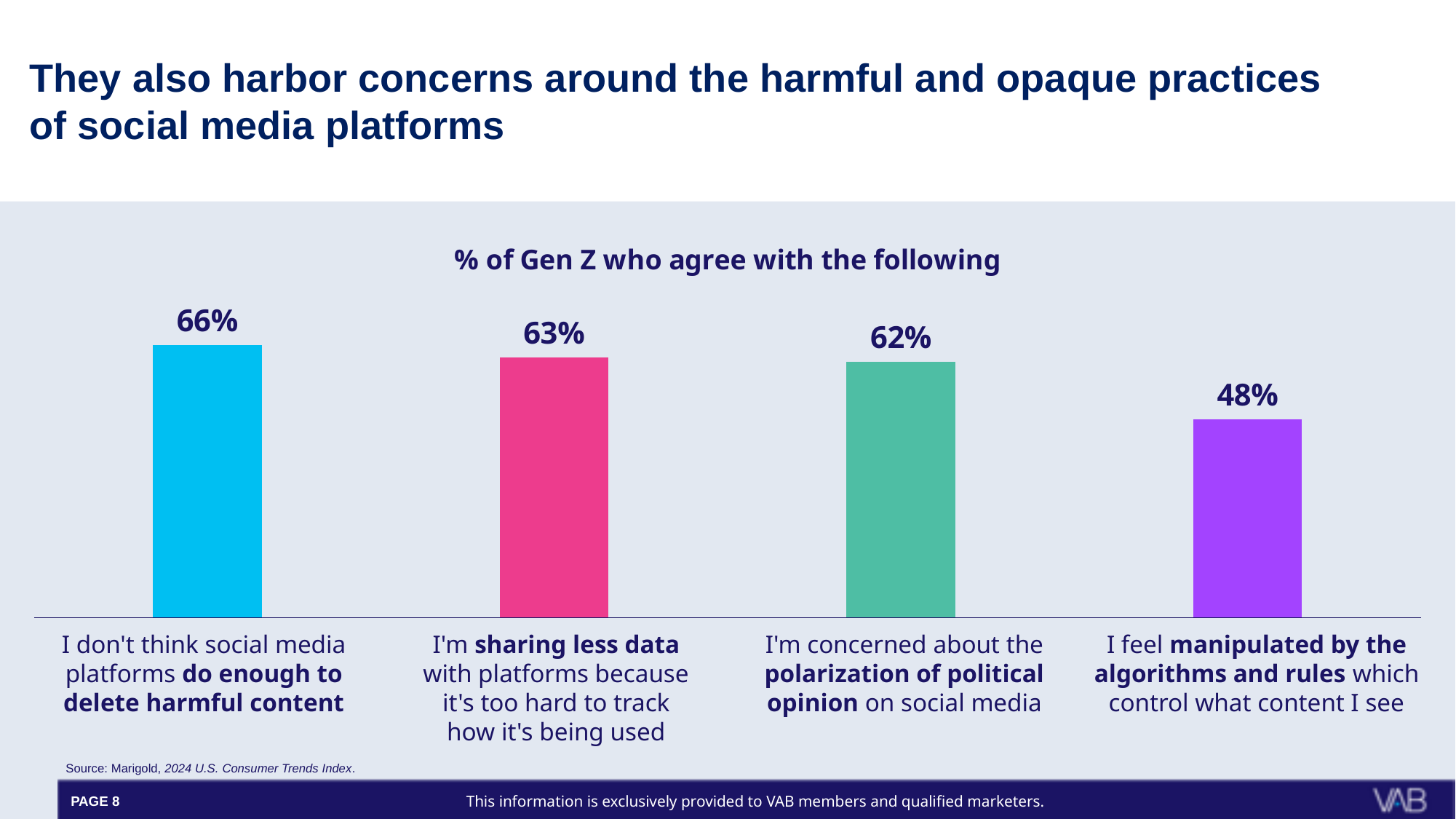
What percentage of Gen Z agree that they don't think social media platforms do enough to delete harmful content? 66% Which statement has the lowest share of Gen Z agreement? I feel manipulated by the algorithms and rules which control what content I see What percentage of Gen Z agree that they are sharing less data with platforms because it's too hard to track how it's being used? 63% What is the difference between the 'sharing less data' value and the 'polarization of political opinion' value? 1 percentage point What is the title of the chart? % of Gen Z who agree with the following What percentage of Gen Z agree that they are concerned about the polarization of political opinion on social media? 62% Which is larger: the share agreeing they are sharing less data with platforms, or the share agreeing they feel manipulated by the algorithms? Sharing less data with platforms What type of chart is shown on the slide? Bar chart Which statement has the highest share of Gen Z agreement? I don't think social media platforms do enough to delete harmful content How many statements (bars) are shown in the chart? 4 What percentage of Gen Z agree that they feel manipulated by the algorithms and rules which control what content they see? 48% What is the difference in percentage points between the 'do enough to delete harmful content' bar and the 'manipulated by the algorithms and rules' bar? 18 percentage points